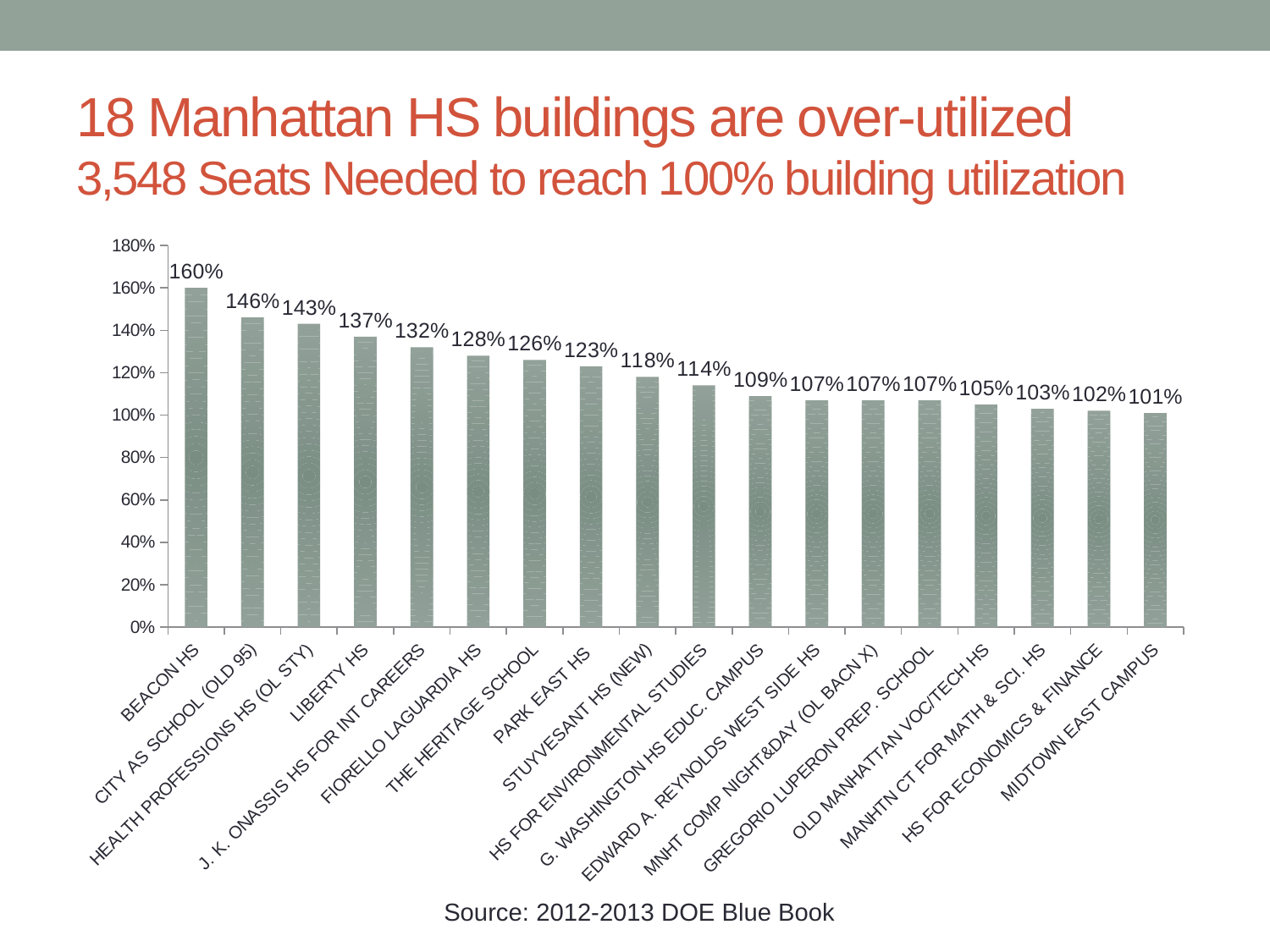
How many school buildings are shown in the chart? 18 Which school building has the lowest utilization? MIDTOWN EAST CAMPUS What is the utilization value for STUYVESANT HS (NEW)? 118% Which has a higher utilization, FIORELLO LAGUARDIA HS or PARK EAST HS? FIORELLO LAGUARDIA HS What kind of chart is shown on the slide? Bar chart What is the utilization value for LIBERTY HS? 137% What source is cited for the chart data? 2012-2013 DOE Blue Book Do the values rise or fall from left to right along the x axis? Fall What is the utilization value for MIDTOWN EAST CAMPUS? 101% What is the difference between the utilization of BEACON HS and CITY AS SCHOOL (OLD 95)? 14% Which school building has the highest utilization? BEACON HS What is the utilization value for BEACON HS? 160%